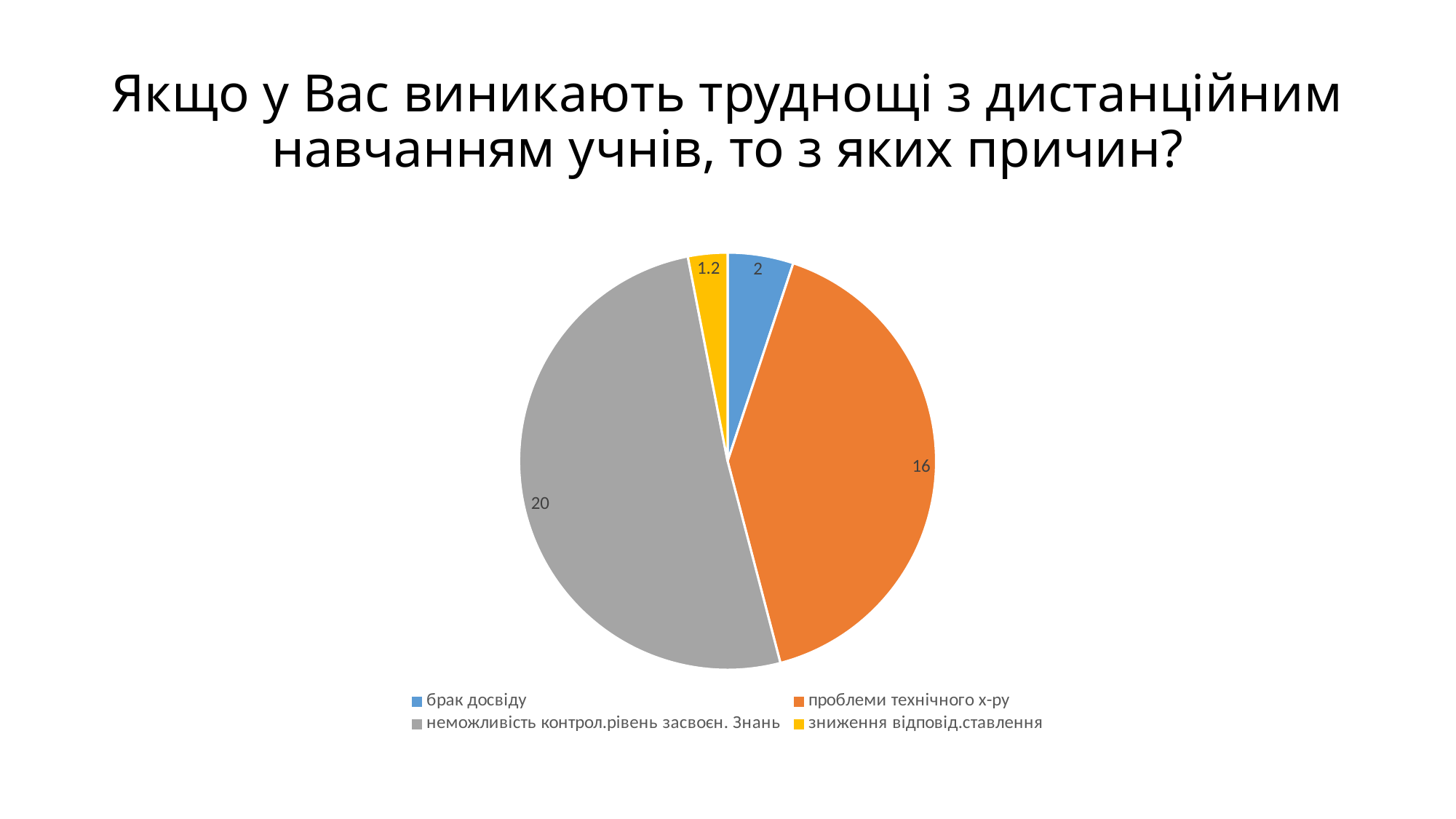
What colour is the slice for "проблеми технічного х-ру"? orange Which category has the smallest slice of the pie? зниження відповід.ставлення Which is larger: the value for "брак досвіду" or the value for "зниження відповід.ставлення"? брак досвіду What is the value for "проблеми технічного х-ру"? 16 What is the difference between the values for "неможливість контрол.рівень засвоєн. Знань" and "проблеми технічного х-ру"? 4 What kind of chart is shown on the slide? pie chart What is the value for "неможливість контрол.рівень засвоєн. Знань"? 20 What is the value for "брак досвіду"? 2 What is the value for "зниження відповід.ставлення"? 1.2 How many categories does the pie chart have? 4 Which category has the largest slice of the pie? неможливість контрол.рівень засвоєн. Знань What is the total of all the values shown in the pie chart? 39.2